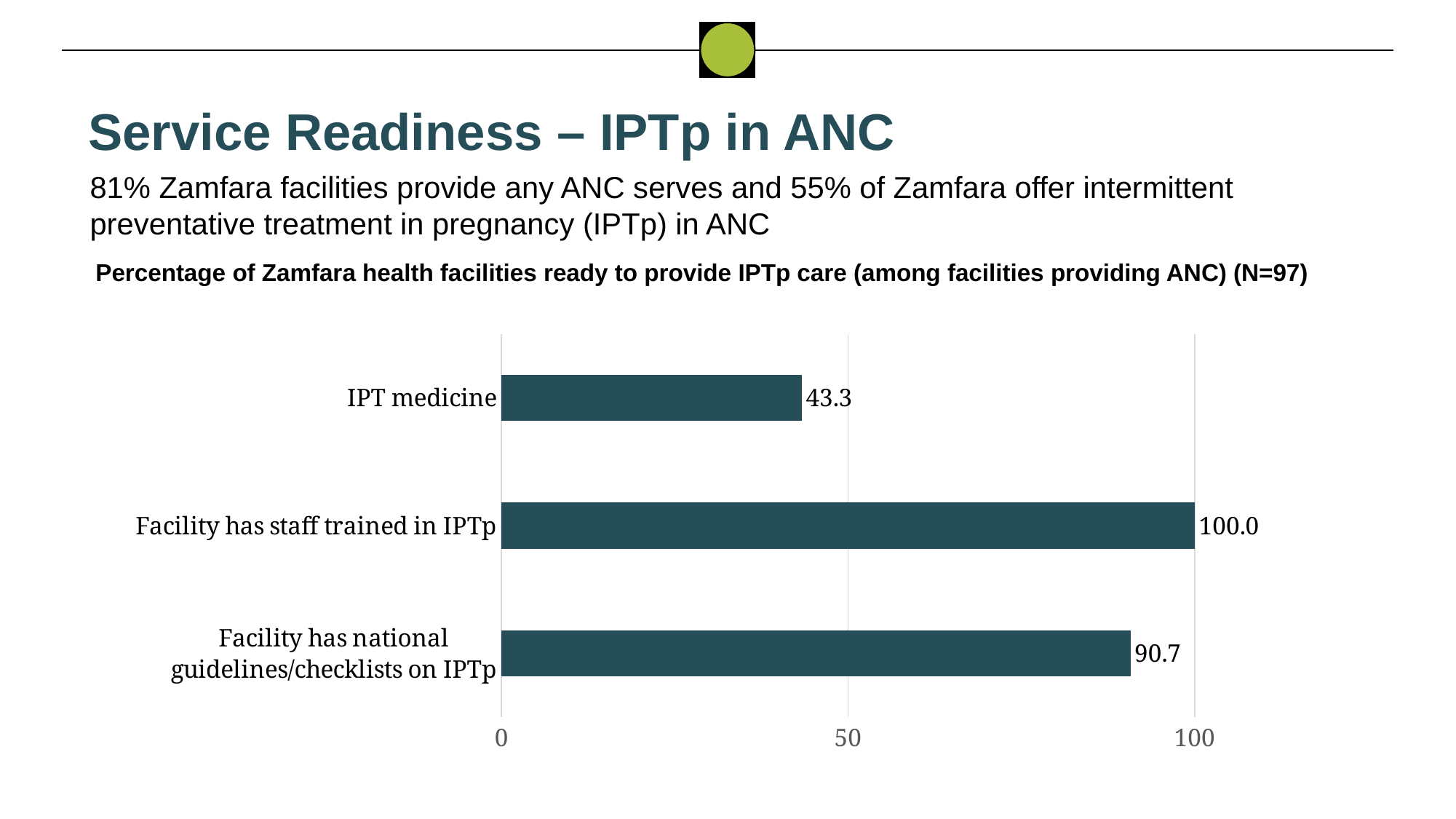
Is the value for IPT medicine greater or less than 50? less Which category has the lowest value? IPT medicine What is the sample size (N) stated in the chart title? N=97 What is the difference between the value for Facility has national guidelines/checklists on IPTp and the value for IPT medicine? 47.4 Which category has the highest value? Facility has staff trained in IPTp How many categories are shown in the chart? 3 What kind of chart is shown on the slide? bar chart What is the value for Facility has staff trained in IPTp? 100.0 Which is larger: the value for Facility has national guidelines/checklists on IPTp or the value for IPT medicine? Facility has national guidelines/checklists on IPTp What is the value for IPT medicine? 43.3 What is the difference between the value for Facility has staff trained in IPTp and the value for IPT medicine? 56.7 What is the value for Facility has national guidelines/checklists on IPTp? 90.7